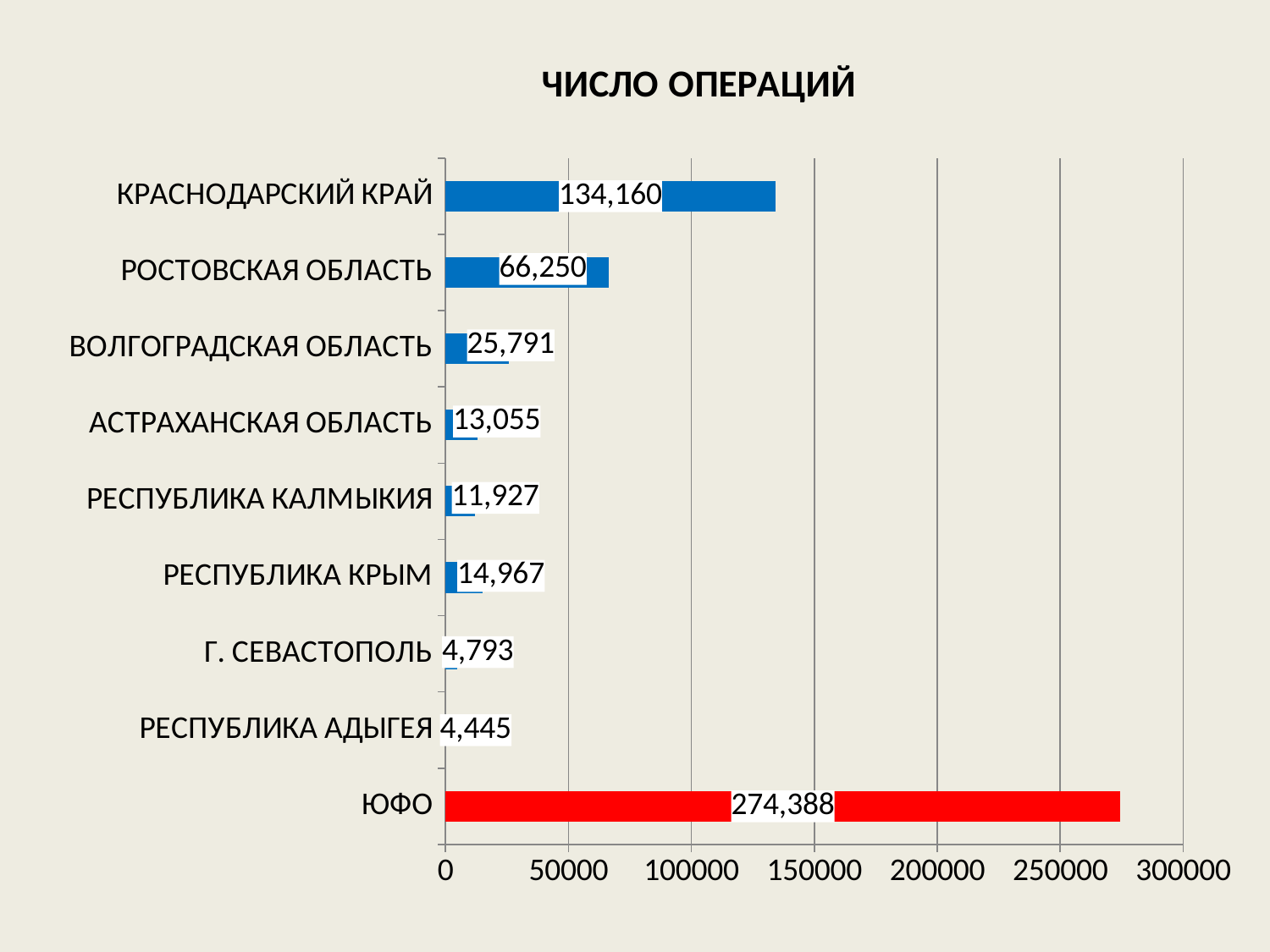
Which category has the lowest value? Республика Адыгея What is the difference between the values for Краснодарский край and Ростовская область? 67,910 Which category has the highest value? ЮФО What is the value for ЮФО? 274,388 Which is larger, the value for Астраханская область or the value for Республика Калмыкия? Астраханская область What is the value for Краснодарский край? 134,160 How many categories are shown on the chart? 9 What is the value for Ростовская область? 66,250 What is the title of the chart? ЧИСЛО ОПЕРАЦИЙ Is the value for Волгоградская область greater or less than 50000? less What kind of chart is shown on the slide? bar chart What is the value for Республика Крым? 14,967